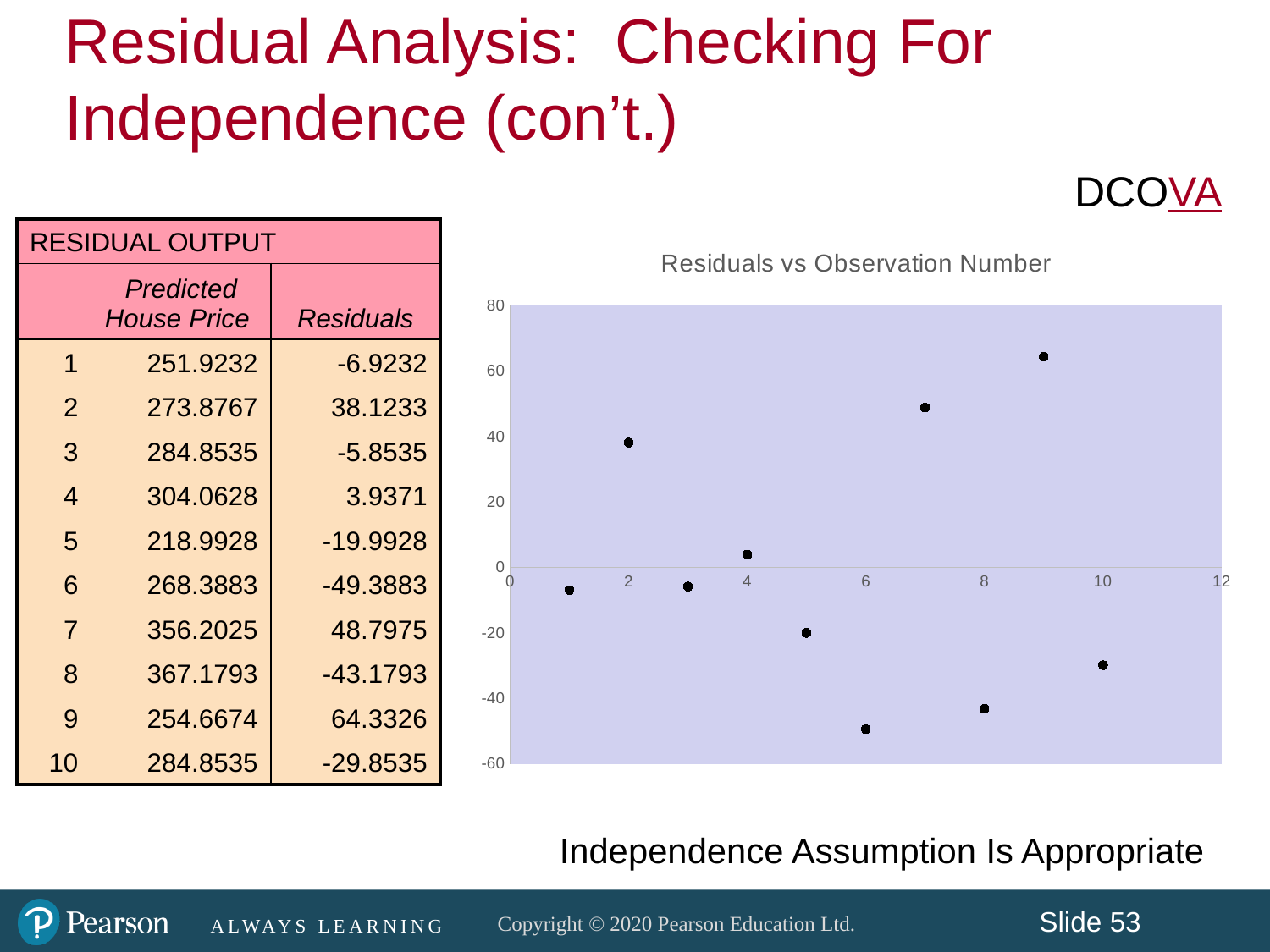
Is the residual for observation 6 greater or less than -40? less What kind of chart is shown on the slide? scatter chart How many points are plotted in the Residuals vs Observation Number chart? 10 Is the residual for observation 10 greater or less than -20? less What is the highest value shown on the vertical axis of the chart? 80 Which has the larger residual, observation 2 or observation 7? observation 7 What is the residual plotted for observation 9, as given in the Residual Output table? 64.3326 Is the residual for observation 7 greater or less than 40? greater Which observation number has the highest residual in the chart? 9 Which observation number has the lowest residual in the chart? 6 What is the title of the chart? Residuals vs Observation Number